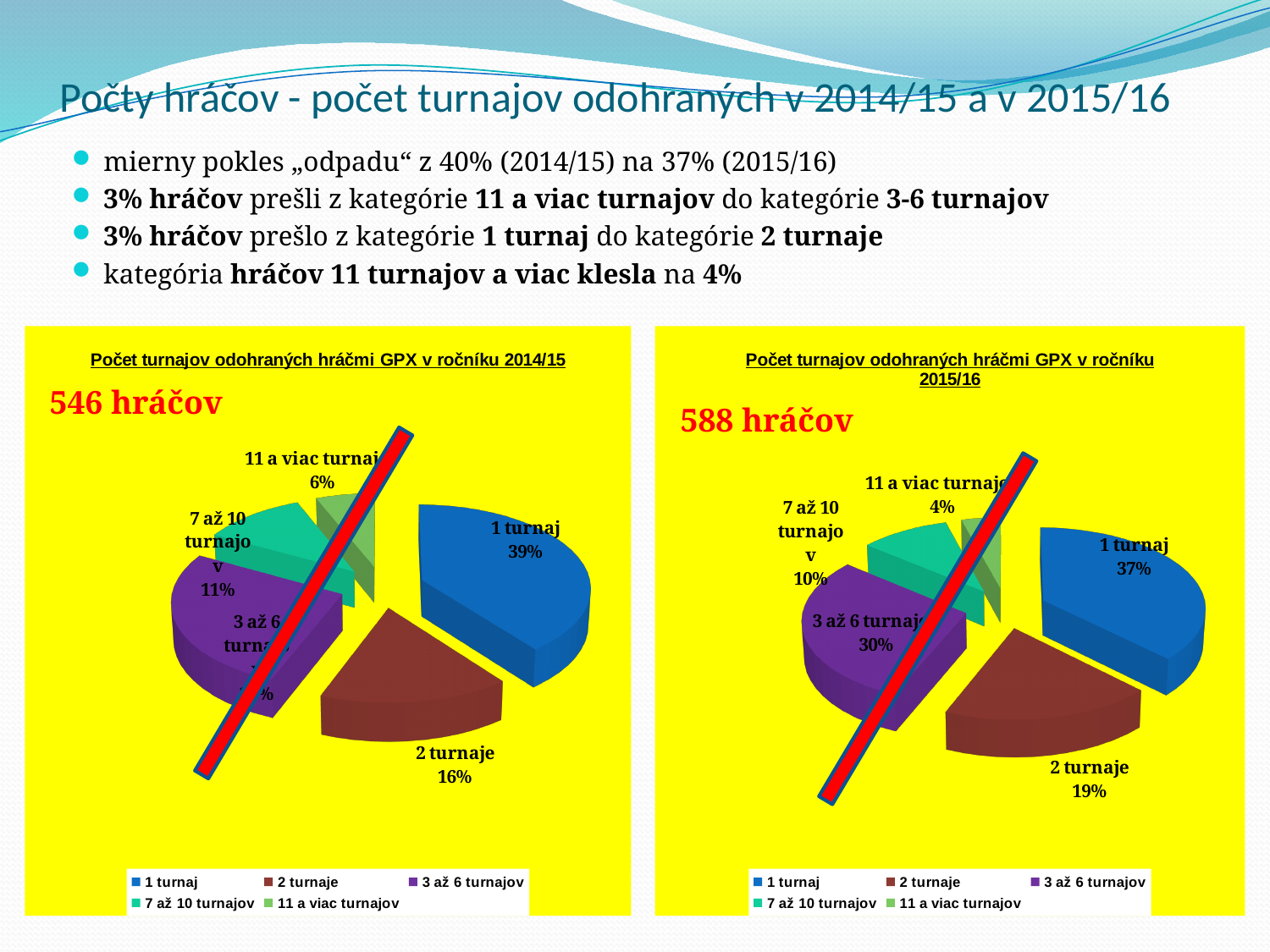
In the right chart (2015/16), which category has the smallest share? 11 a viac turnajov In the left chart (2014/15), what percentage of players played 1 turnaj? 39% How many categories does the legend of the right chart (2015/16) list? 5 What total number of players is shown on the right chart (2015/16)? 588 hráčov What type of chart is the left chart (2014/15)? Pie chart In the left chart (2014/15), which is larger: the share for 7 až 10 turnajov or for 11 a viac turnajov? 7 až 10 turnajov In the right chart (2015/16), what percentage of players played 7 až 10 turnajov? 10% In the right chart (2015/16), what is the difference in percentage points between the 1 turnaj and 2 turnaje slices? 18 In the left chart (2014/15), what percentage of players played 11 a viac turnajov? 6% In the left chart (2014/15), what percentage of players played 2 turnaje? 16% In the right chart (2015/16), what percentage of players played 3 až 6 turnajov? 30% In the right chart (2015/16), which category has the largest share? 1 turnaj